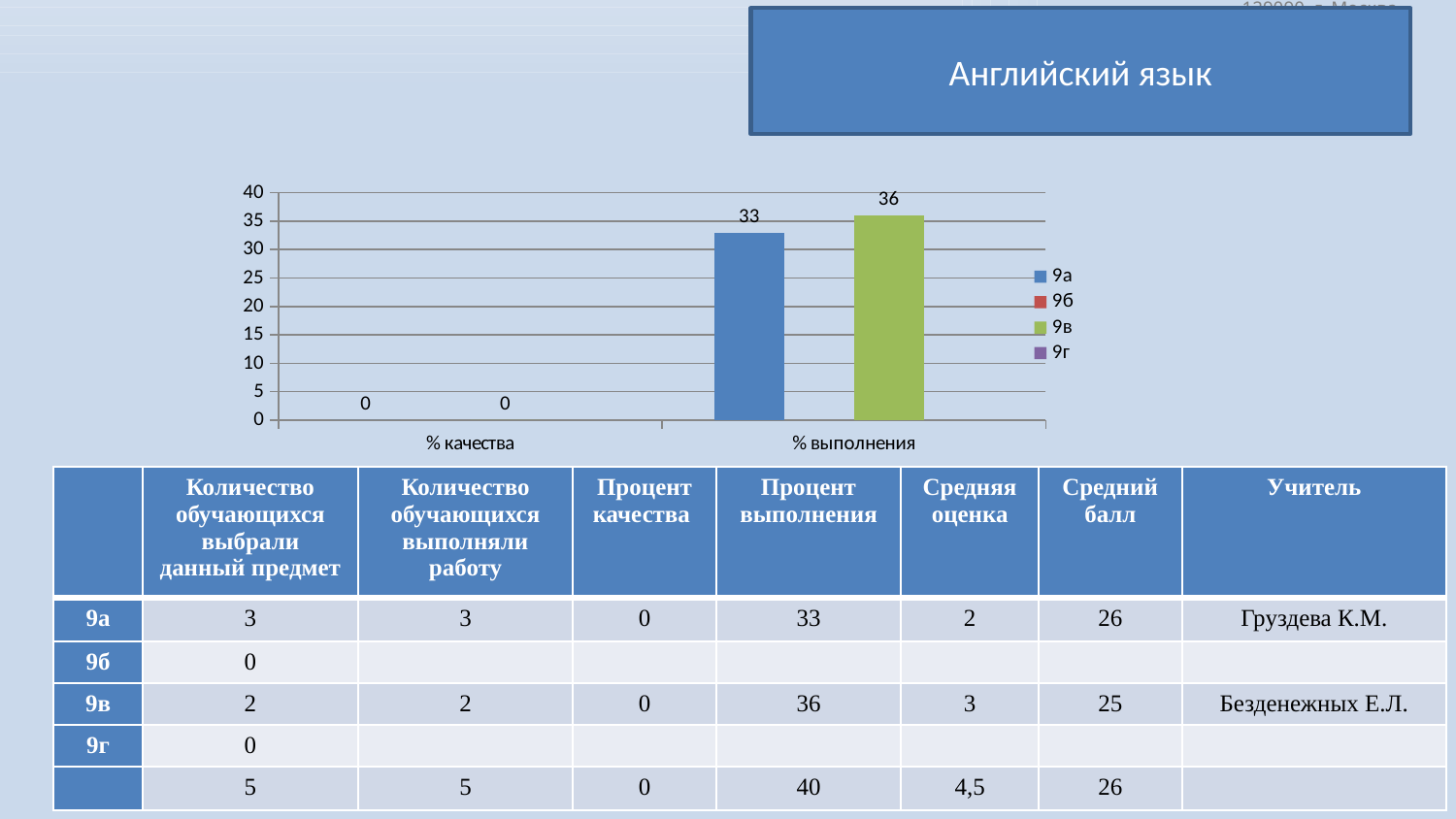
What is the value for 9в in the % выполнения category? 36 How many series does the chart legend list? 4 Which is larger in the % выполнения category: 9а or 9в? 9в How many categories are shown on the x axis of the chart? 2 What is the maximum value shown on the chart's vertical axis? 40 What is the difference between the 9в and 9а values in the % выполнения category? 3 What is the value for 9а in the % качества category? 0 Is the value for 9а in % выполнения greater or less than 30? greater What kind of chart is shown on the slide? bar chart What is the value for 9а in the % выполнения category? 33 Which series has the highest value in the % выполнения category? 9в What is the value for 9в in the % качества category? 0